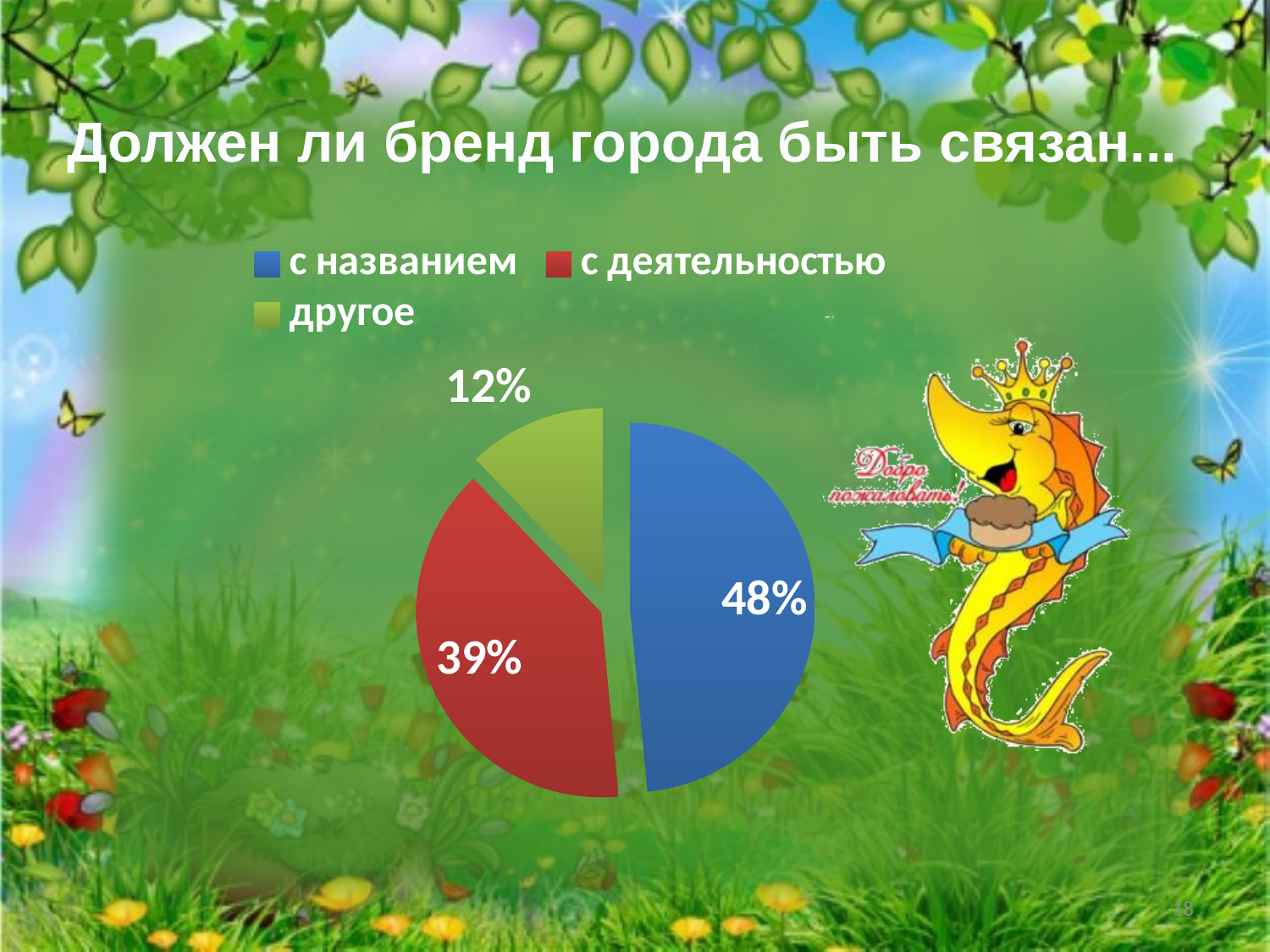
What share of the pie does 'с деятельностью' have? 39% What share of the pie does 'с названием' have? 48% What colour is the slice for 'другое'? green What kind of chart is shown on the slide? pie chart Which category has the largest slice of the pie? с названием Which is larger: the slice for 'с деятельностью' or the slice for 'другое'? с деятельностью How many slices does the pie chart have? 3 Which category has the smallest slice of the pie? другое How many entries does the legend list? 3 What is the difference in percentage points between 'с названием' and 'с деятельностью'? 9 What share of the pie does 'другое' have? 12% What is the difference in percentage points between 'с деятельностью' and 'другое'? 27